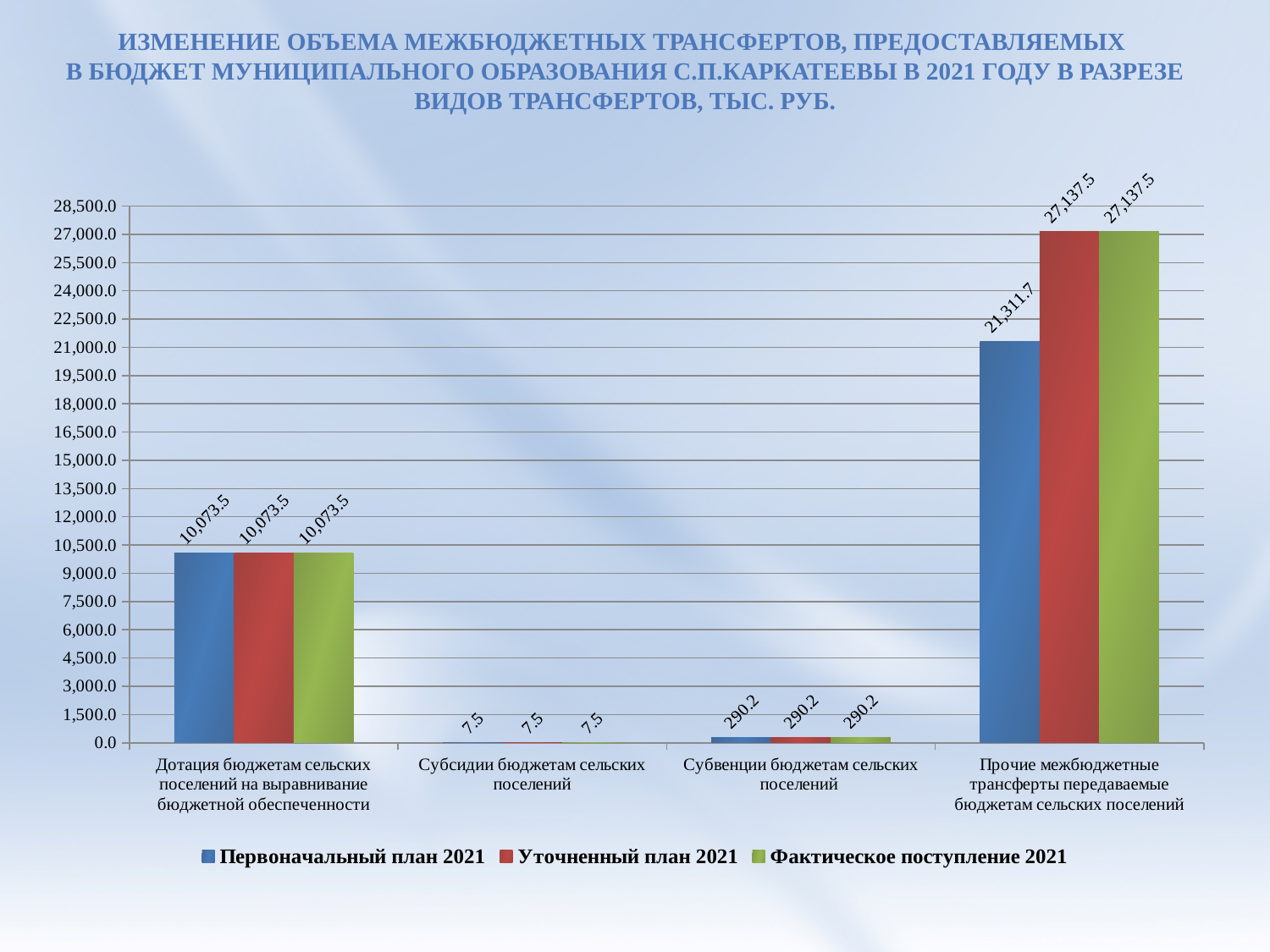
What is the value of Фактическое поступление 2021 for Дотация бюджетам сельских поселений на выравнивание бюджетной обеспеченности? 10,073.5 Which category has the lowest value for Первоначальный план 2021? Субсидии бюджетам сельских поселений Which is larger for Прочие межбюджетные трансферты передаваемые бюджетам сельских поселений: Первоначальный план 2021 or Уточненный план 2021? Уточненный план 2021 What is the value of Первоначальный план 2021 for Прочие межбюджетные трансферты передаваемые бюджетам сельских поселений? 21,311.7 What is the difference between Уточненный план 2021 and Первоначальный план 2021 for Прочие межбюджетные трансферты передаваемые бюджетам сельских поселений? 5,825.8 What is the value of Уточненный план 2021 for Субвенции бюджетам сельских поселений? 290.2 What is the value of Первоначальный план 2021 for Субсидии бюджетам сельских поселений? 7.5 How many series does the legend list? 3 What is the value of Уточненный план 2021 for Прочие межбюджетные трансферты передаваемые бюджетам сельских поселений? 27,137.5 What kind of chart is shown on the slide? Bar chart How many categories are shown on the x axis? 4 Which category has the highest value for Фактическое поступление 2021? Прочие межбюджетные трансферты передаваемые бюджетам сельских поселений